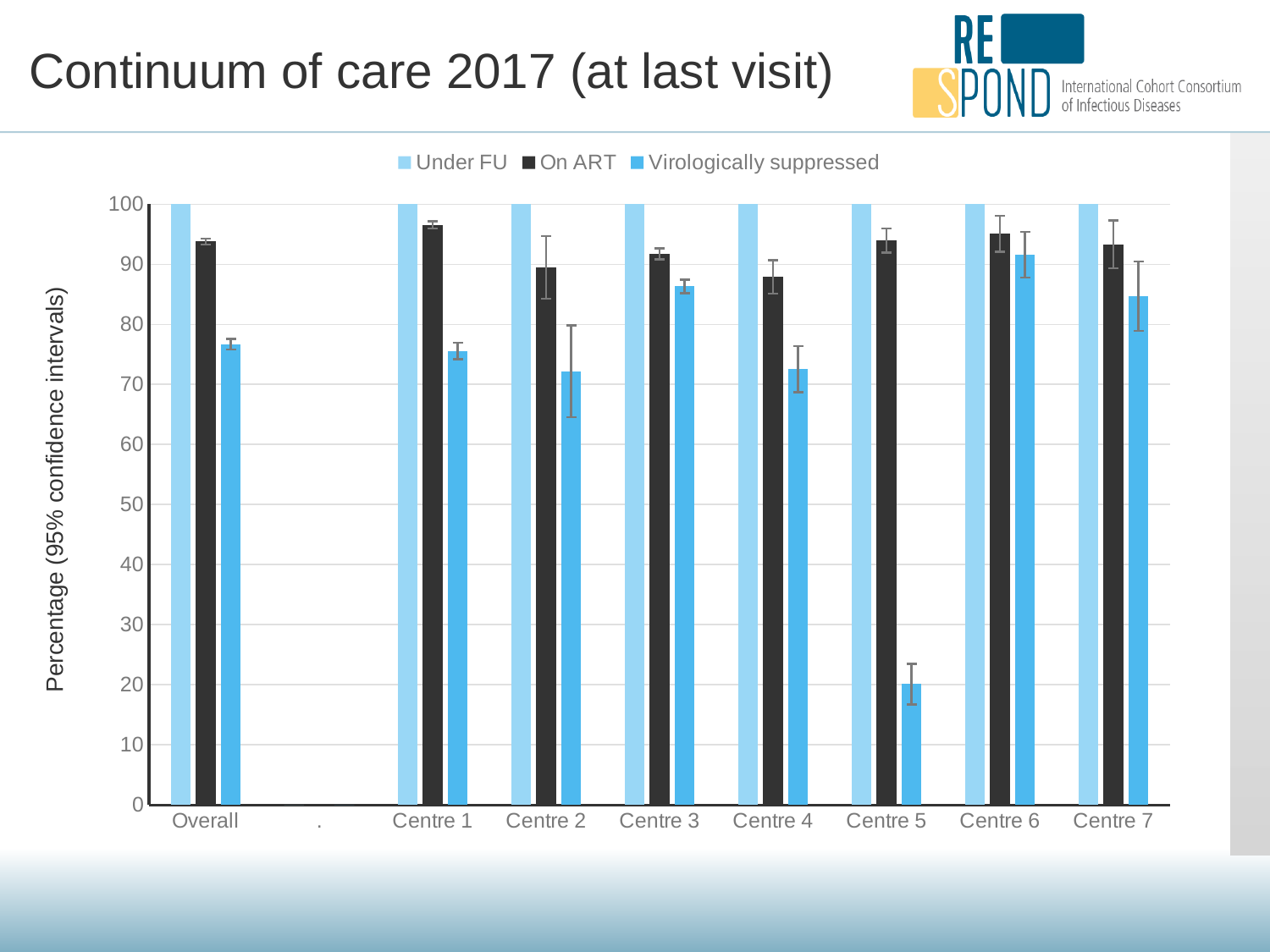
What is the label on the y axis? Percentage (95% confidence intervals) Is the Virologically suppressed value for Centre 3 greater or less than 80? greater How many series does the legend list? 3 Which category has the lowest Virologically suppressed value? Centre 5 Is the Virologically suppressed value for Centre 2 greater or less than 80? less Which is larger, the Virologically suppressed value for Centre 4 or for Centre 5? Centre 4 Which is larger, the Virologically suppressed value for Centre 3 or for Centre 1? Centre 3 Is the On ART value for Centre 4 greater or less than 90? less What is the Under FU value for Overall? 100 What kind of chart is shown on the slide? bar chart How many centres (Centre 1 to Centre 7) are shown on the x axis? 7 Which centre has the highest Virologically suppressed value? Centre 6